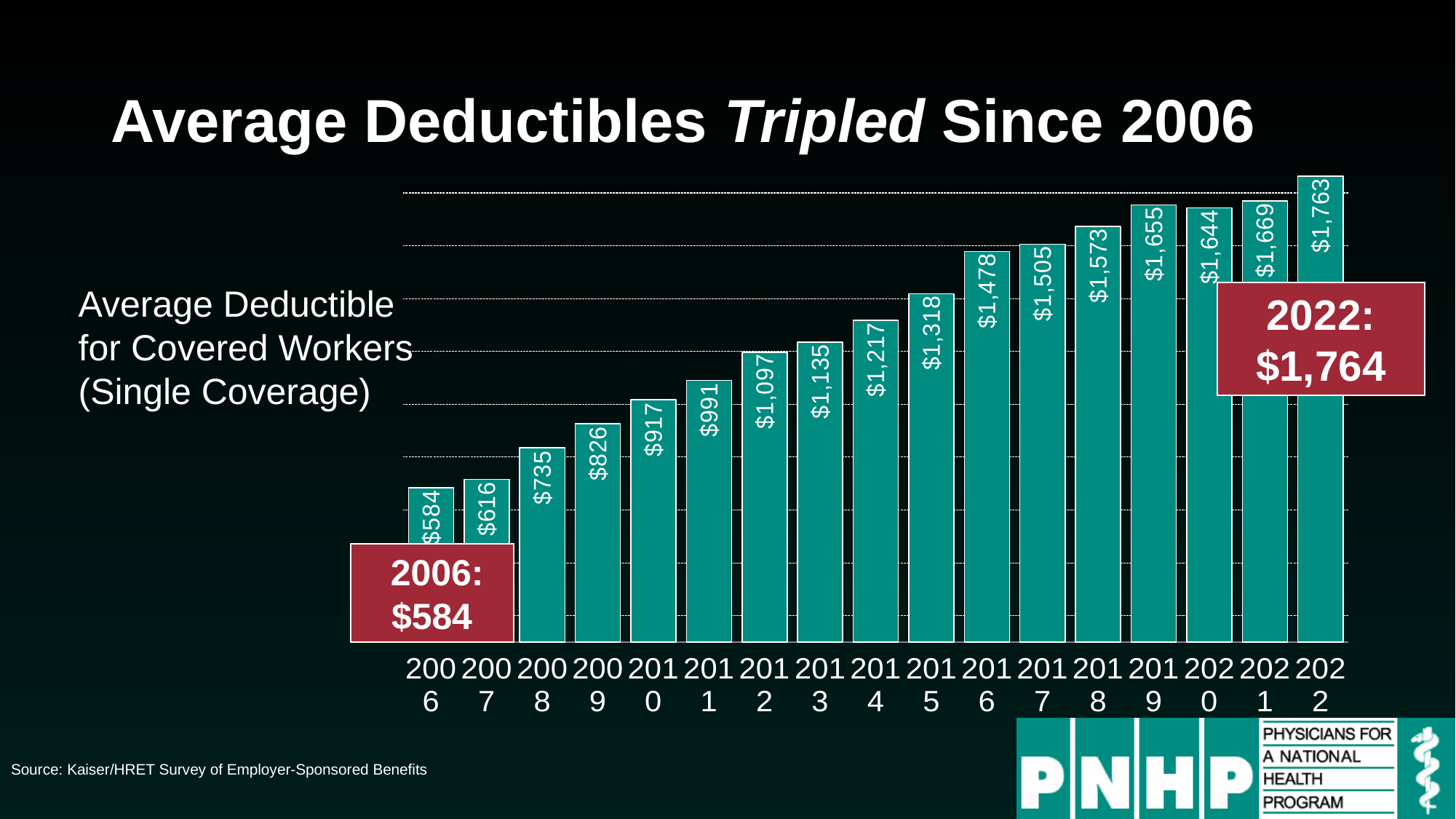
Which year has the larger average deductible, 2019 or 2020? 2019 Do the average deductibles generally rise or fall from 2006 to 2022? Rise What kind of chart is shown on the slide? Bar chart What is the difference between the average deductible in 2010 and in 2009? $91 Which year has the lowest average deductible? 2006 How many years are plotted in the chart? 17 What is the average deductible shown for 2006? $584 What is the title of the slide? Average Deductibles Tripled Since 2006 What is the difference between the average deductible in 2016 and in 2015? $160 What is the average deductible shown for 2015? $1,318 Which year has the highest average deductible? 2022 What is the average deductible shown for 2010? $917